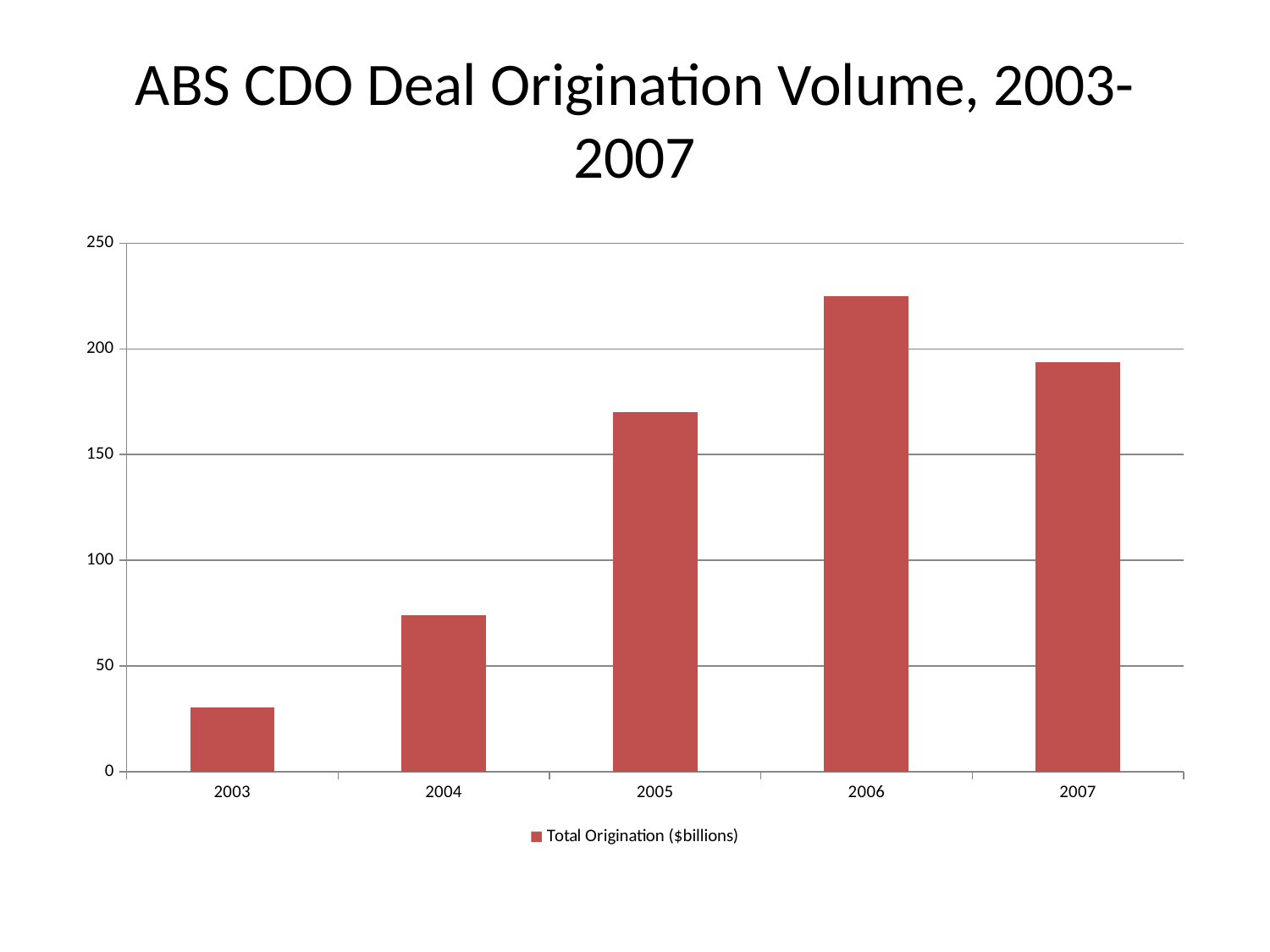
Is the value for 2007 greater or less than 200? less Which year has the lowest total origination? 2003 What kind of chart is shown on the slide? bar chart Is the value for 2006 greater or less than 200? greater Is the value for 2003 greater or less than 50? less Do the values rise or fall from 2003 to 2006? rise What is the legend entry for the series shown? Total Origination ($billions) How many years are shown on the x axis? 5 Which is larger, the value for 2004 or the value for 2005? 2005 Which year has the highest total origination? 2006 How many series does the legend list? 1